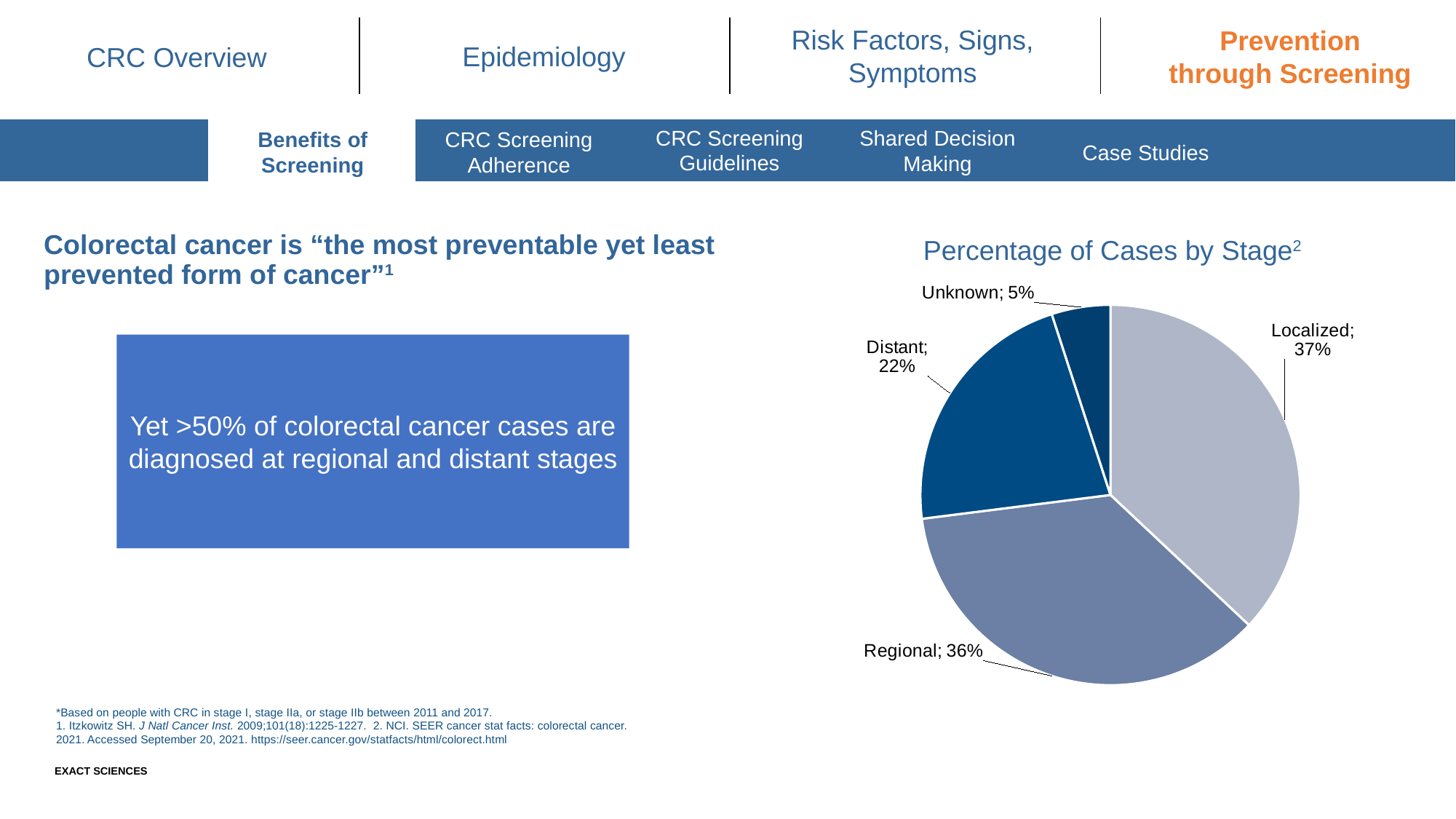
What kind of chart is shown on the slide? Pie chart Which stage accounts for the smallest share of cases? Unknown What is the combined percentage of cases at the Regional and Distant stages? 58% Which is larger, the Regional slice or the Distant slice? Regional What is the difference in percentage points between the Distant and Unknown slices? 17 What percentage of cases have an Unknown stage? 5% What percentage of cases are at the Distant stage? 22% How many slices does the pie chart have? 4 What is the title of the chart? Percentage of Cases by Stage What percentage of cases are at the Localized stage? 37% What percentage of cases are at the Regional stage? 36% Which stage accounts for the largest share of cases? Localized